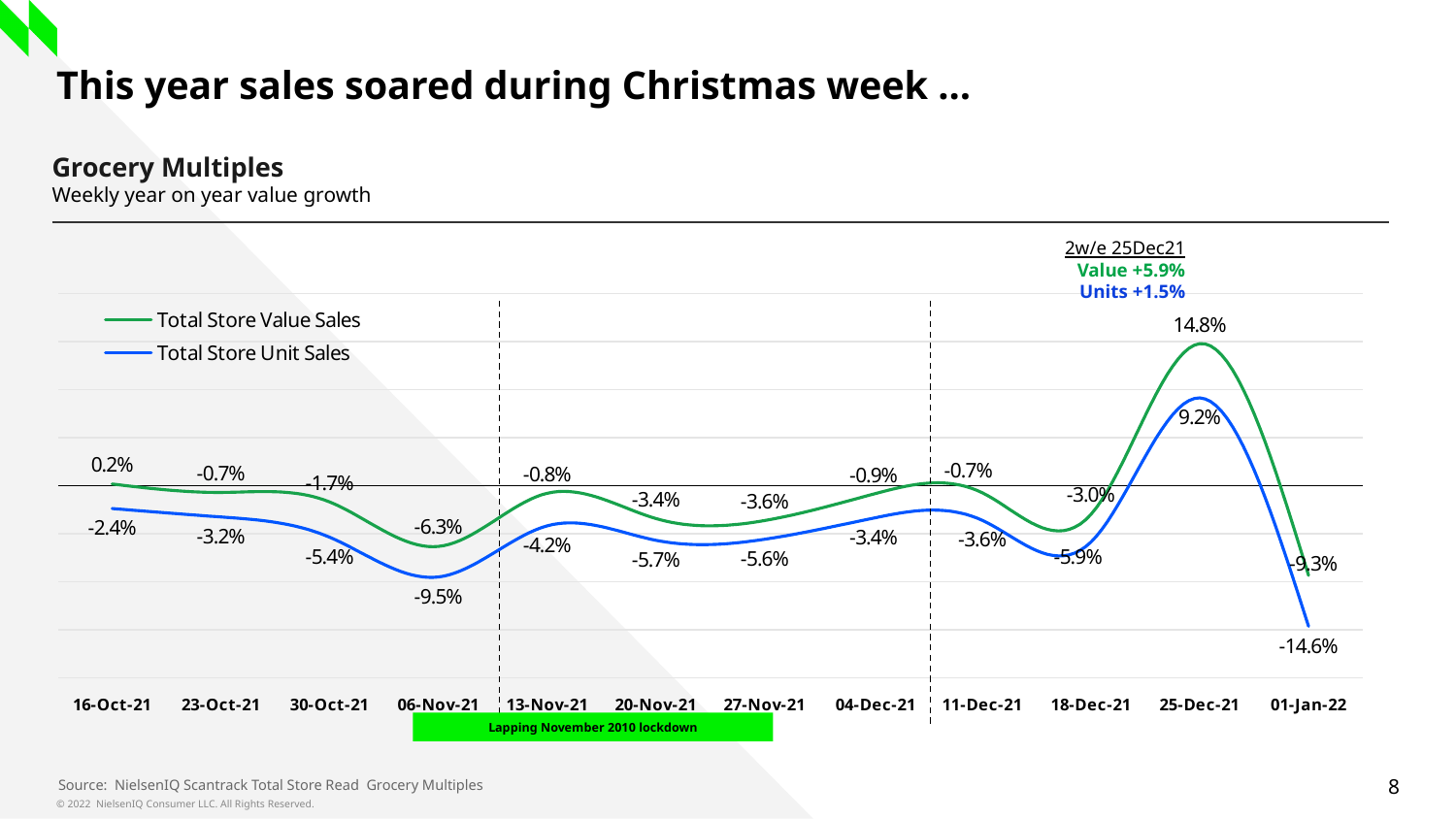
How many series does the legend list? 2 How many weekly data points are plotted along the x axis? 12 What is the Total Store Unit Sales growth for the week of 06-Nov-21? -9.5% What is the difference between Total Store Value Sales and Total Store Unit Sales growth for the week of 25-Dec-21? 5.6 percentage points Which series has the higher value for the week of 16-Oct-21, Total Store Value Sales or Total Store Unit Sales? Total Store Value Sales Which week has the lowest Total Store Unit Sales growth? 01-Jan-22 What does the green box below the x axis say? Lapping November 2010 lockdown Do the Total Store Value Sales values rise or fall between 25-Dec-21 and 01-Jan-22? Fall Which week has the highest Total Store Value Sales growth? 25-Dec-21 What is the Total Store Value Sales growth for the week of 25-Dec-21? 14.8% What type of chart is shown on the slide? Line chart What is the Total Store Unit Sales growth for the week of 01-Jan-22? -14.6%